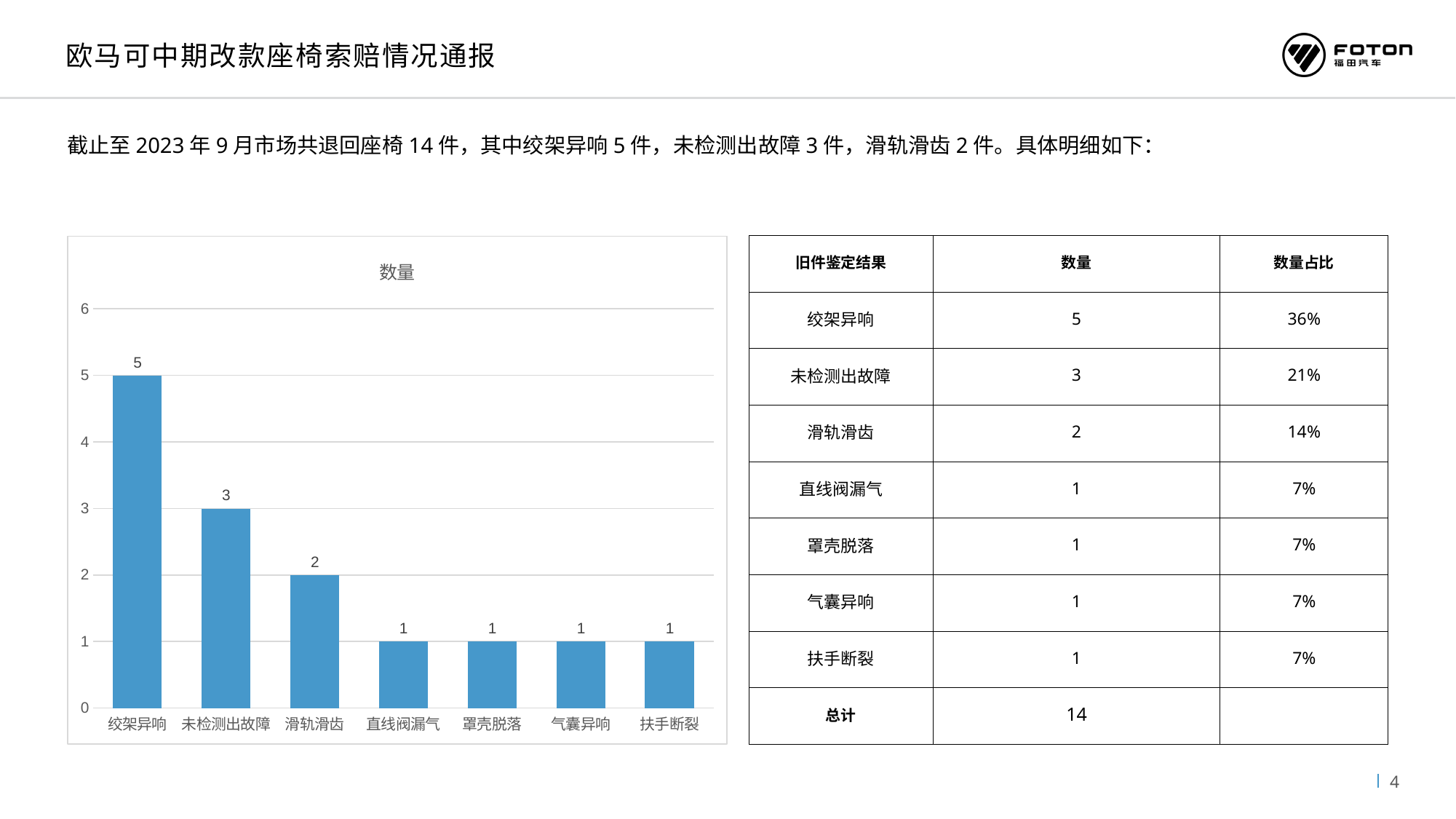
How many categories are shown on the x axis of the chart? 7 What is the value for 未检测出故障 in the chart? 3 Is the value for 绞架异响 greater or less than 4? greater What is the value for 绞架异响 in the chart? 5 Which is larger, the value for 滑轨滑齿 or the value for 直线阀漏气? 滑轨滑齿 What is the difference between the values for 未检测出故障 and 滑轨滑齿? 1 Which category has the highest value in the chart? 绞架异响 What is the value for 滑轨滑齿 in the chart? 2 What is the value for 气囊异响 in the chart? 1 What kind of chart is shown on the slide? bar chart What is the difference between the values for 绞架异响 and 未检测出故障? 2 What is the title of the chart? 数量